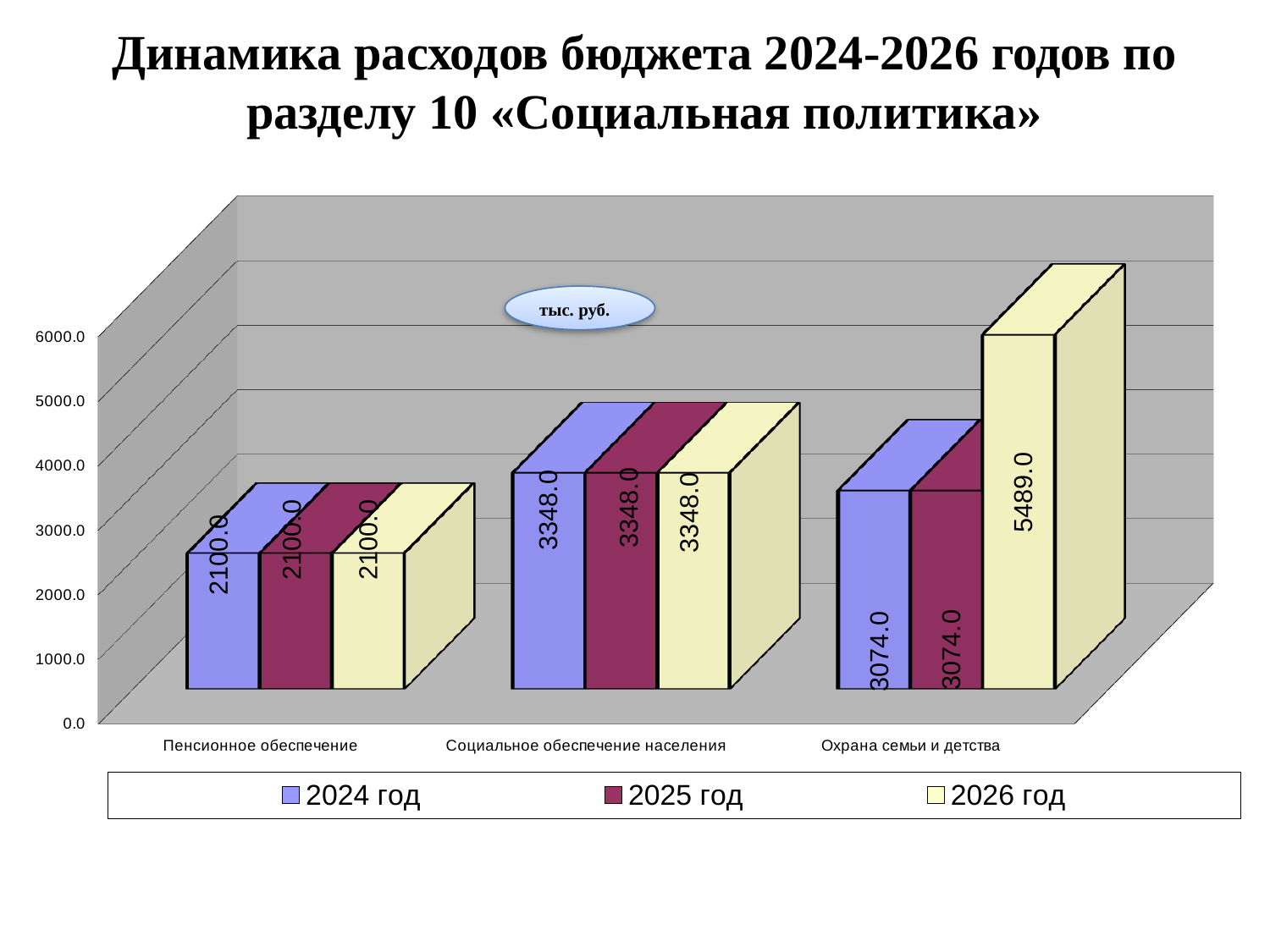
Which category has the highest value in 2026 год? Охрана семьи и детства How many series does the legend list? 3 What is the value for Социальное обеспечение населения in 2025 год? 3348.0 What unit is indicated in the callout on the chart? тыс. руб. What kind of chart is shown on the slide? Bar chart What is the difference between the 2026 год and 2025 год values for Охрана семьи и детства? 2415.0 What is the value for Охрана семьи и детства in 2026 год? 5489.0 What is the value for Пенсионное обеспечение in 2024 год? 2100.0 Which is larger for 2024 год: Социальное обеспечение населения or Охрана семьи и детства? Социальное обеспечение населения Which category has the lowest value in 2024 год? Пенсионное обеспечение How many categories are shown on the x axis? 3 What is the value for Охрана семьи и детства in 2024 год? 3074.0